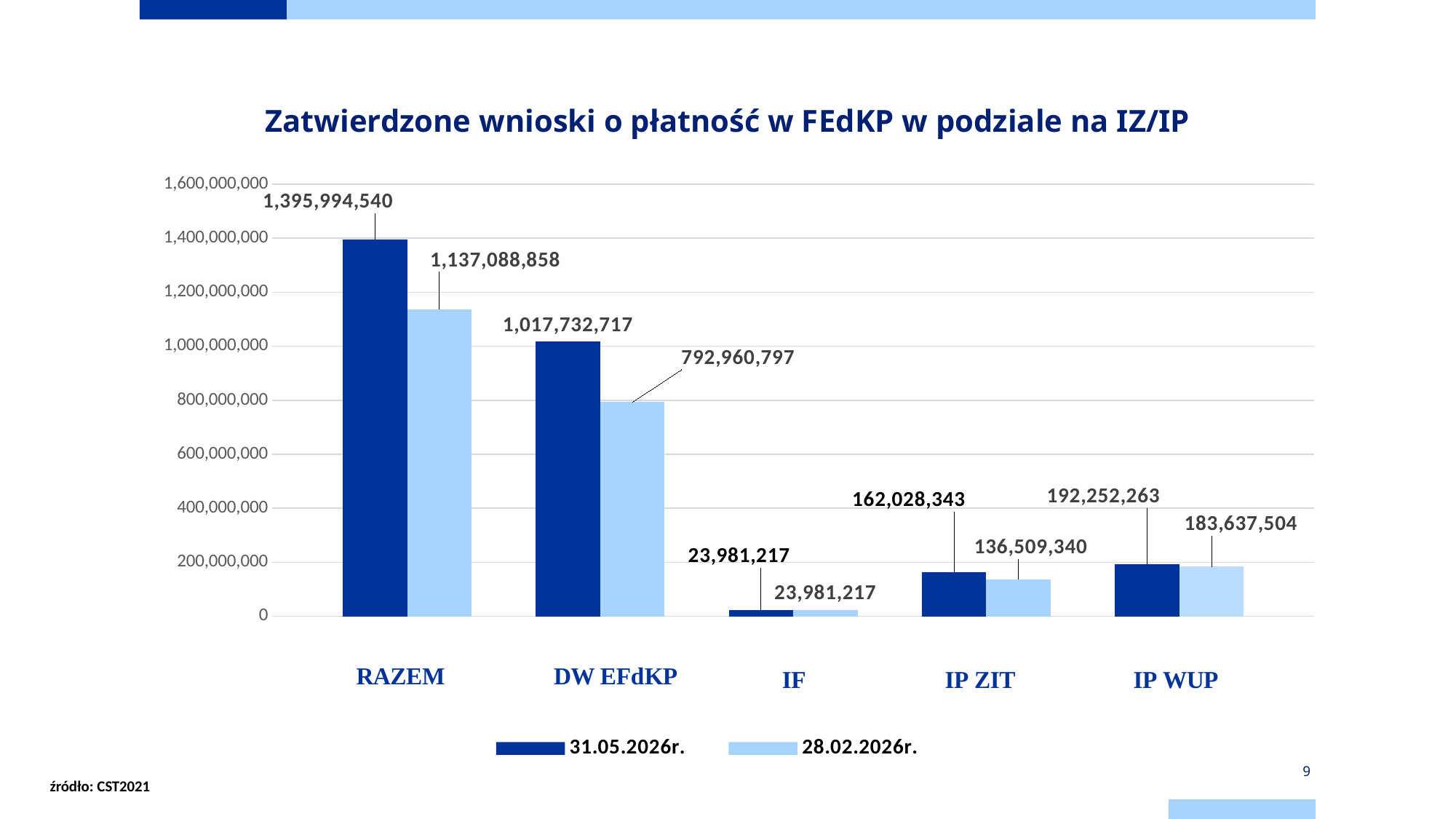
What is the value for IP WUP in the 28.02.2026r. series? 183,637,504 Which category has the highest value in the 28.02.2026r. series? RAZEM What kind of chart is shown on the slide? Bar chart Which category has the lowest value in the 31.05.2026r. series? IF What is the difference between the 31.05.2026r. and 28.02.2026r. values for RAZEM? 258,905,682 What is the value for RAZEM in the 31.05.2026r. series? 1,395,994,540 What is the difference between the 31.05.2026r. and 28.02.2026r. values for IP WUP? 8,614,759 Which is larger for IP ZIT: the 31.05.2026r. value or the 28.02.2026r. value? 31.05.2026r. How many series does the legend list? 2 What is the value for DW EFdKP in the 28.02.2026r. series? 792,960,797 How many categories are shown on the x axis? 5 What is the value for IP ZIT in the 31.05.2026r. series? 162,028,343